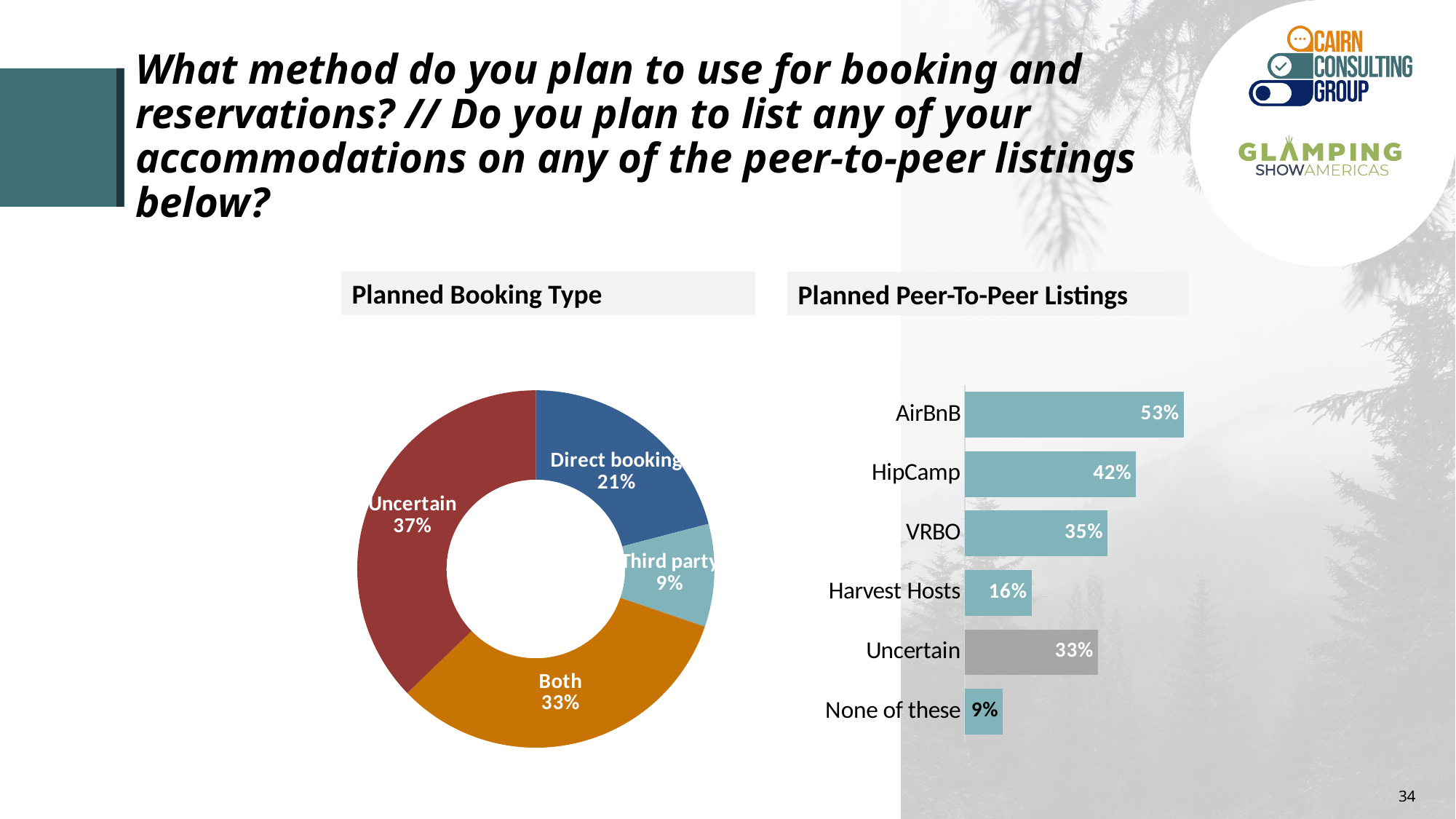
In the Planned Booking Type chart, what percentage is shown for Third party? 9% In the Planned Booking Type chart, which category has the smallest share? Third party In the Planned Peer-To-Peer Listings chart, which listing has the highest value? AirBnB In the Planned Peer-To-Peer Listings chart, how many categories are shown? 6 What kind of chart is the Planned Booking Type chart? Doughnut (pie) chart In the Planned Booking Type chart, what percentage is shown for Uncertain? 37% In the Planned Peer-To-Peer Listings chart, what is the value for HipCamp? 42% In the Planned Peer-To-Peer Listings chart, which is larger, VRBO or Uncertain? VRBO In the Planned Booking Type chart, which category has the largest share? Uncertain In the Planned Peer-To-Peer Listings chart, which category has the lowest value? None of these In the Planned Booking Type chart, what is the difference in percentage points between Both and Direct booking? 12 In the Planned Peer-To-Peer Listings chart, what is the value for Harvest Hosts? 16%